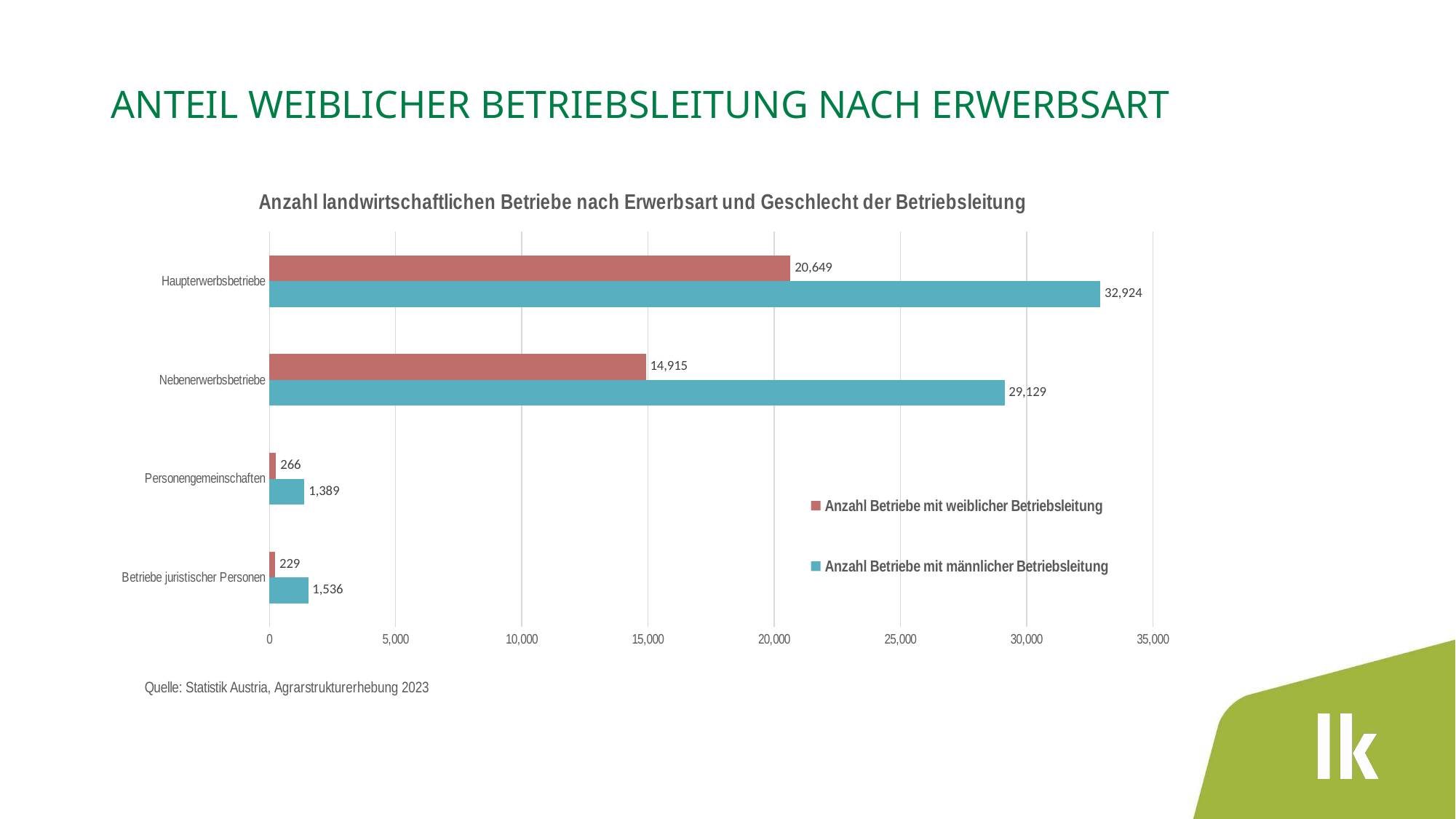
Which category has the highest number of Betriebe mit männlicher Betriebsleitung? Haupterwerbsbetriebe How many categories are shown on the y axis of the chart? 4 Which category has the lowest number of Betriebe mit weiblicher Betriebsleitung? Betriebe juristischer Personen What is the number of Betriebe mit weiblicher Betriebsleitung for Haupterwerbsbetriebe? 20,649 What kind of chart is shown on the slide? Bar chart How many series does the legend list? 2 Which is larger: the number of female-led Nebenerwerbsbetriebe or the number of female-led Haupterwerbsbetriebe? Haupterwerbsbetriebe What is the difference between the male-led and female-led Haupterwerbsbetriebe? 12,275 What is the title of the chart? Anzahl landwirtschaftlichen Betriebe nach Erwerbsart und Geschlecht der Betriebsleitung What is the number of Betriebe mit weiblicher Betriebsleitung for Personengemeinschaften? 266 What is the number of Betriebe mit männlicher Betriebsleitung for Nebenerwerbsbetriebe? 29,129 What is the number of Betriebe mit männlicher Betriebsleitung for Betriebe juristischer Personen? 1,536